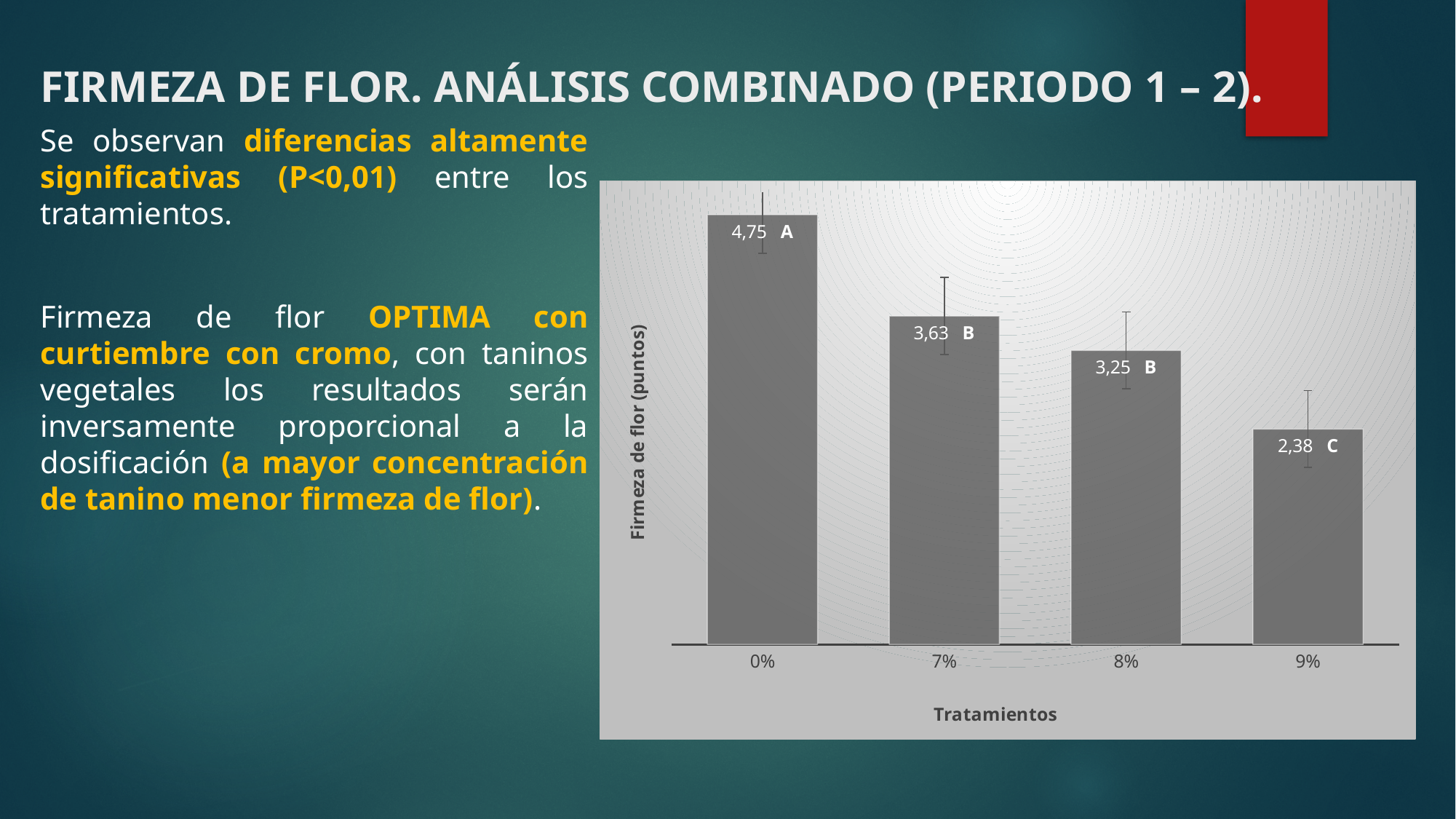
Which treatment has a larger Firmeza de flor, 7% or 9%? 7% What is the value of Firmeza de flor for the 7% treatment? 3,63 What is the value of Firmeza de flor for the 8% treatment? 3,25 How many treatments are shown on the x axis of the chart? 4 What is the difference in Firmeza de flor between the 7% and 8% treatments? 0,38 Which treatment has the highest Firmeza de flor? 0% Which treatment has the lowest Firmeza de flor? 9% What is the value of Firmeza de flor for the 0% treatment? 4,75 What kind of chart is shown on the slide? Bar chart Do the Firmeza de flor values rise or fall as the treatment concentration increases along the x axis? Fall What is the value of Firmeza de flor for the 9% treatment? 2,38 What is the difference in Firmeza de flor between the 0% and 9% treatments? 2,37